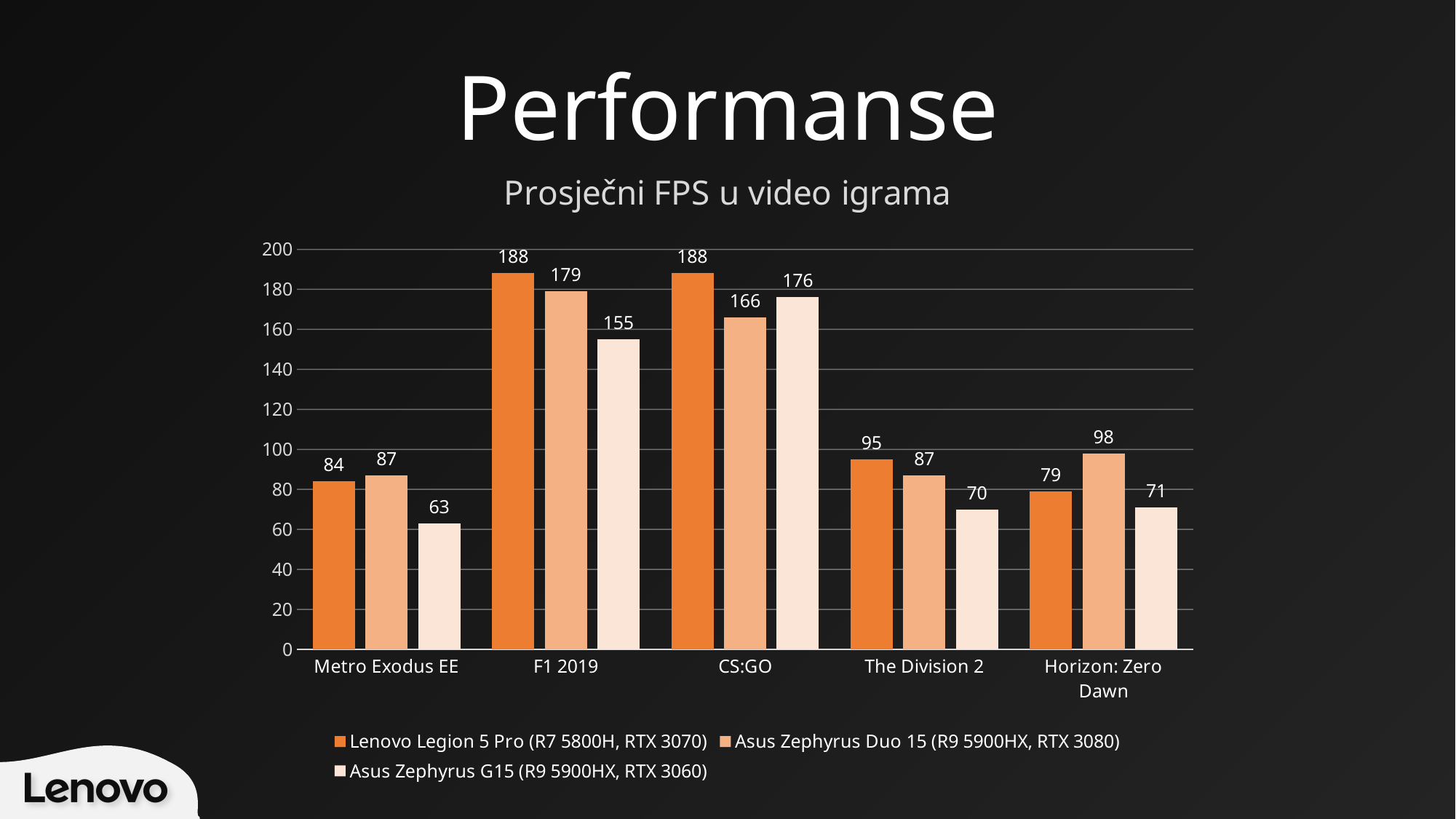
What is the difference in average FPS between the Lenovo Legion 5 Pro and the Asus Zephyrus G15 in F1 2019? 33 What is the average FPS for the Asus Zephyrus Duo 15 in CS:GO? 166 What is the subtitle of the chart below the title 'Performanse'? Prosječni FPS u video igrama What kind of chart is shown on the slide? Bar chart What is the average FPS for the Asus Zephyrus G15 in Metro Exodus EE? 63 Is the average FPS for the Asus Zephyrus G15 in CS:GO greater or less than 160? greater In which game does the Lenovo Legion 5 Pro have its lowest average FPS? Horizon: Zero Dawn In which game does the Asus Zephyrus Duo 15 achieve its highest average FPS? F1 2019 What is the average FPS for the Lenovo Legion 5 Pro in F1 2019? 188 How many laptops (series) does the legend list? 3 In Horizon: Zero Dawn, which laptop has the higher average FPS: the Lenovo Legion 5 Pro or the Asus Zephyrus Duo 15? Asus Zephyrus Duo 15 How many games are shown on the x axis of the chart? 5